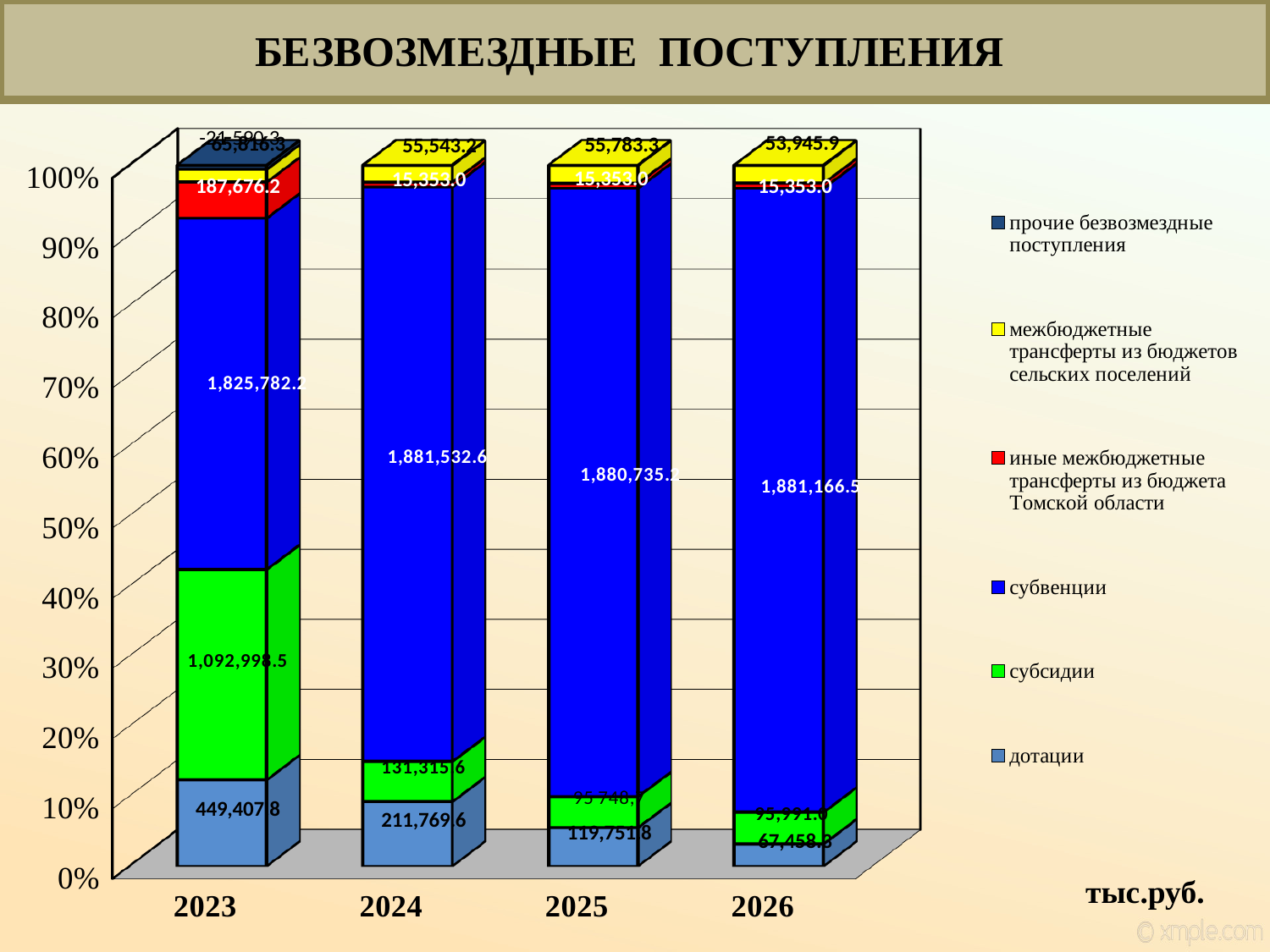
How many series does the legend list? 6 What is the value for дотации in 2023? 449,407.8 What is the value for иные межбюджетные трансферты из бюджета Томской области in 2023? 187,676.2 Do the values for дотации rise or fall from 2023 to 2026? fall What is the value for субсидии in 2023? 1,092,998.5 What is the difference between субвенции and субсидии in 2023? 732,783.7 What is the title of the chart? БЕЗВОЗМЕЗДНЫЕ ПОСТУПЛЕНИЯ What is the value for межбюджетные трансферты из бюджетов сельских поселений in 2026? 53,945.9 What is the value for субвенции in 2024? 1,881,532.6 What kind of chart is shown on the slide? stacked bar chart How many years are shown on the x axis? 4 Which is larger in 2024, дотации or субсидии? дотации